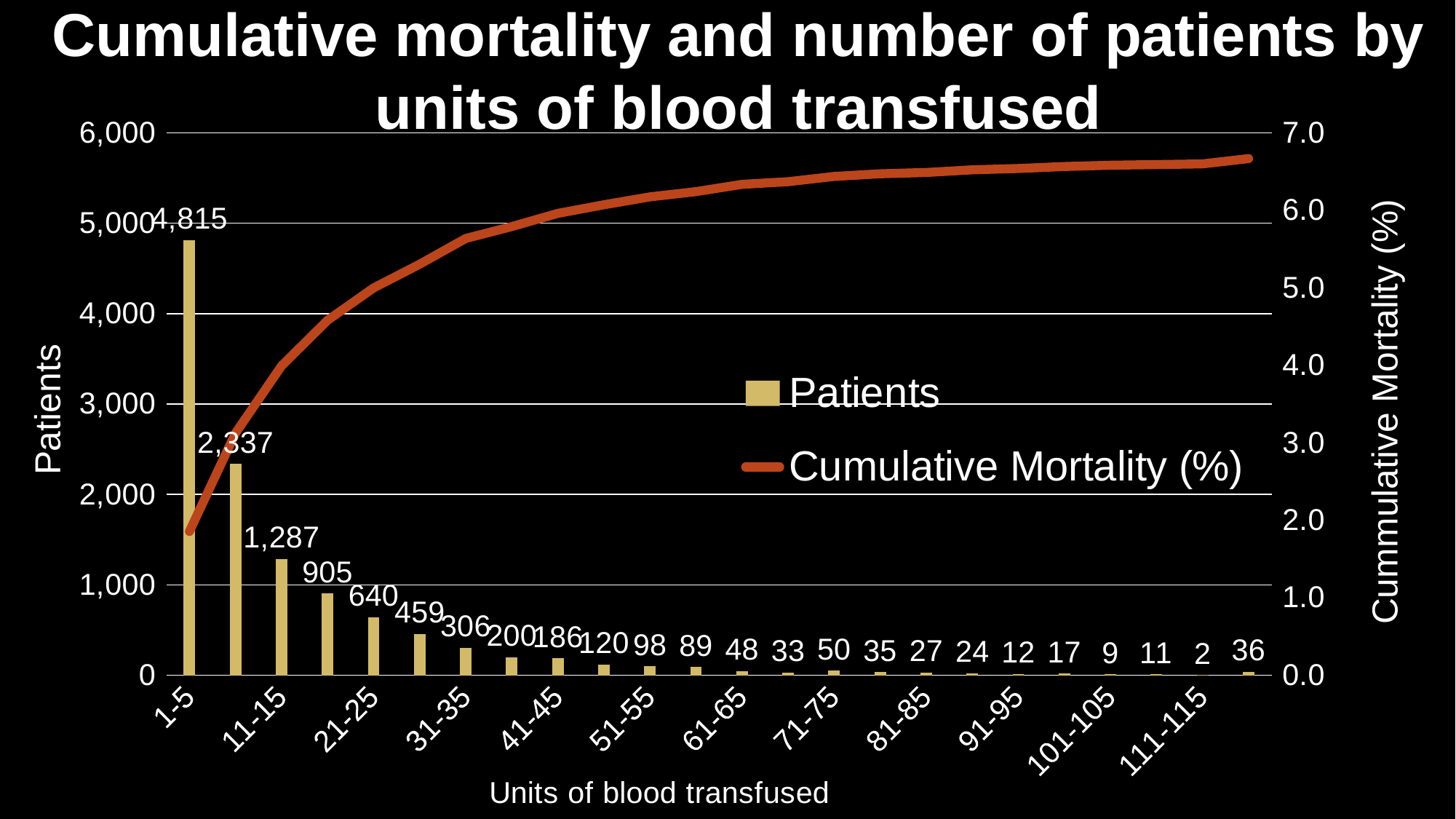
Is the cumulative mortality (%) for the 111-115 units category greater or less than 6.0? greater Which units-of-blood category has the highest number of patients? 1-5 Which labelled units-of-blood category has the lowest number of patients? 111-115 What is the difference in number of patients between the 1-5 and 11-15 units categories? 3,528 What is the number of patients for the 91-95 units category? 12 How many patients received 1-5 units of blood transfused? 4,815 What is the number of patients for the 21-25 units category? 640 Does the cumulative mortality (%) line rise or fall as units of blood transfused increase? rise What is the number of patients for the 11-15 units category? 1,287 How many series does the legend list? 2 Which category has more patients, 61-65 units or 71-75 units? 71-75